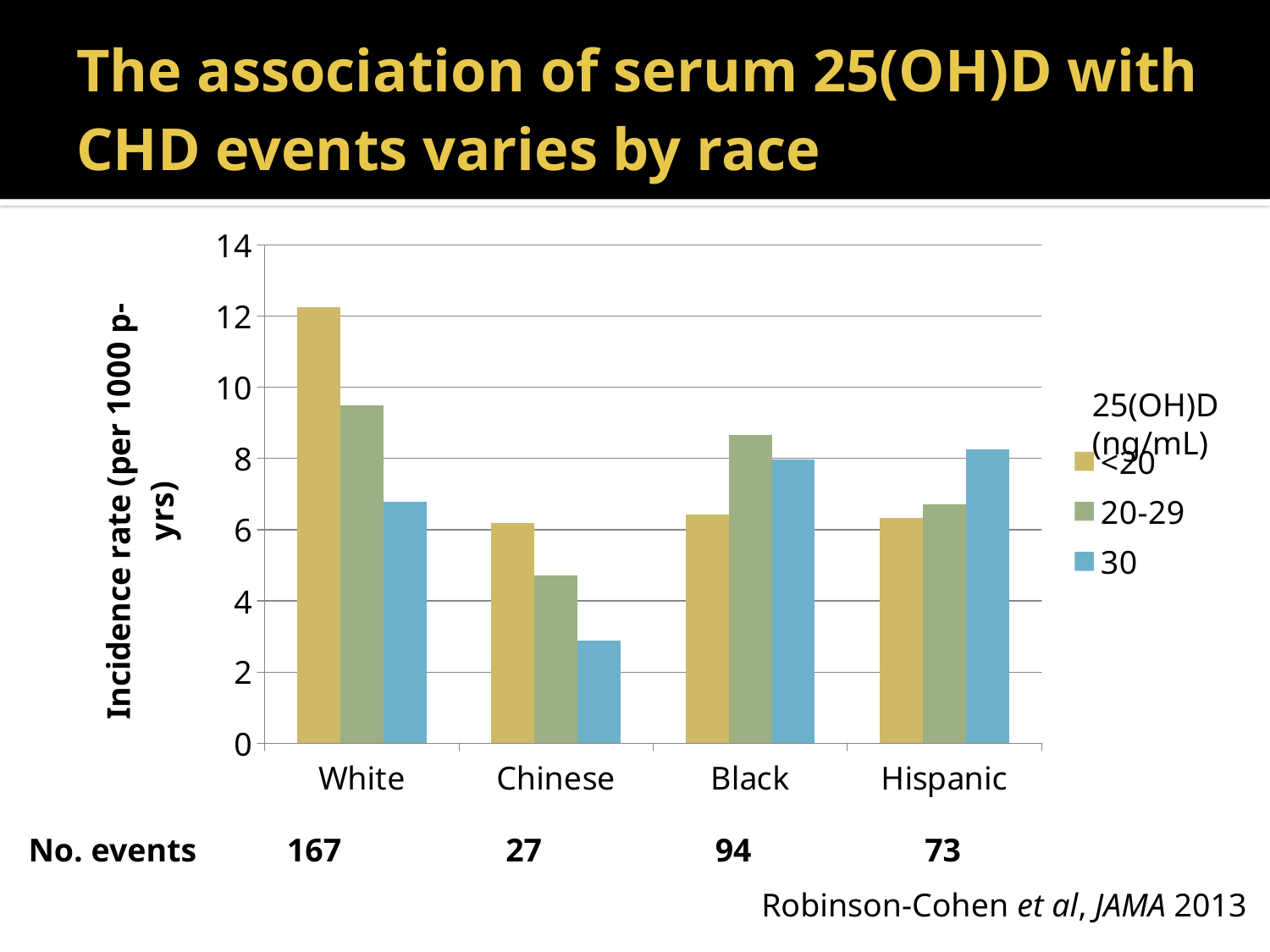
What is the label of the y axis? Incidence rate (per 1000 p-yrs) Which race has the highest incidence rate in the <20 ng/mL group? White What is the number of events listed below the chart for the Chinese group? 27 Is the incidence rate for Chinese participants in the 30 ng/mL group greater or less than 4? less For Hispanic participants, which group has the larger incidence rate: <20 or 30? 30 How many series does the legend list? 3 How many race categories are shown on the x axis? 4 For Black participants, which group has the larger incidence rate: <20 or 20-29? 20-29 Is the incidence rate for White participants with 25(OH)D <20 greater or less than 10? greater Which race has the lowest incidence rate in the 30 ng/mL group? Chinese What kind of chart is shown on the slide? bar chart For White participants, do the incidence rates rise or fall as the 25(OH)D category increases from <20 to 30? fall